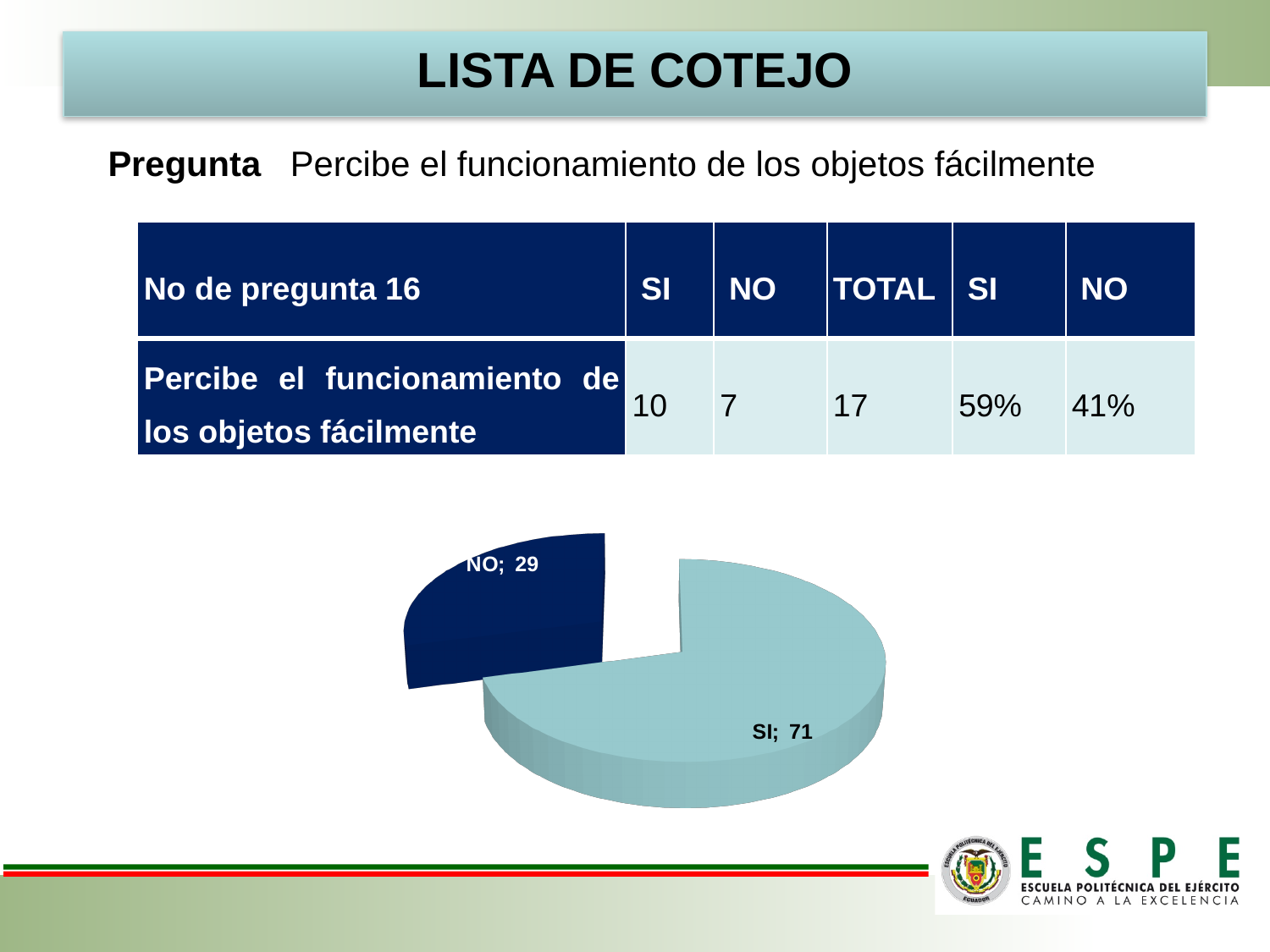
How many slices does the pie chart have? 2 Which slice of the pie chart is the smallest? NO Which is larger in the pie chart, SI or NO? SI What kind of chart is shown on the slide? Pie chart What value is labelled on the SI slice of the pie chart? 71 What colour is the NO slice of the pie chart? Dark blue What value is labelled on the NO slice of the pie chart? 29 Which slice of the pie chart is pulled out (exploded) from the rest? NO What is the total of the two values labelled on the pie chart? 100 What is the difference between the SI and NO values labelled on the pie chart? 42 Which slice of the pie chart is the largest? SI